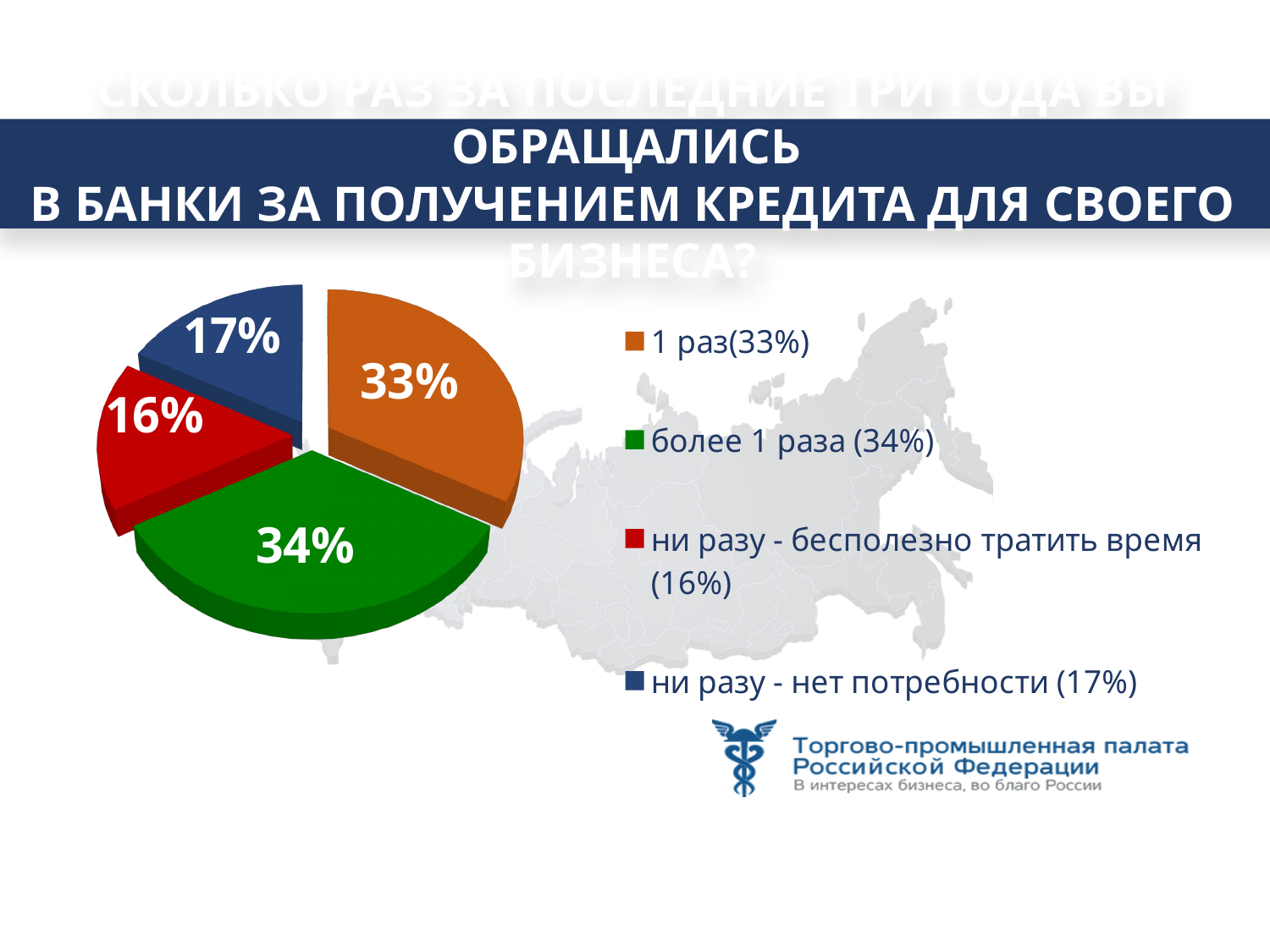
Which category has the smallest share of the pie? ни разу - бесполезно тратить время How many slices does the pie chart have? 4 What type of chart is shown on the slide? Pie chart What share of respondents answered "ни разу - нет потребности"? 17% How many entries does the legend list? 4 What share of respondents answered "ни разу - бесполезно тратить время"? 16% What share of respondents answered "более 1 раза"? 34% What colour is the slice for "более 1 раза"? Green Which is larger: the share for "ни разу - нет потребности" or for "ни разу - бесполезно тратить время"? ни разу - нет потребности What share of respondents answered "1 раз"? 33% Which category has the largest share of the pie? более 1 раза What is the difference in percentage points between "1 раз" and "ни разу - нет потребности"? 16